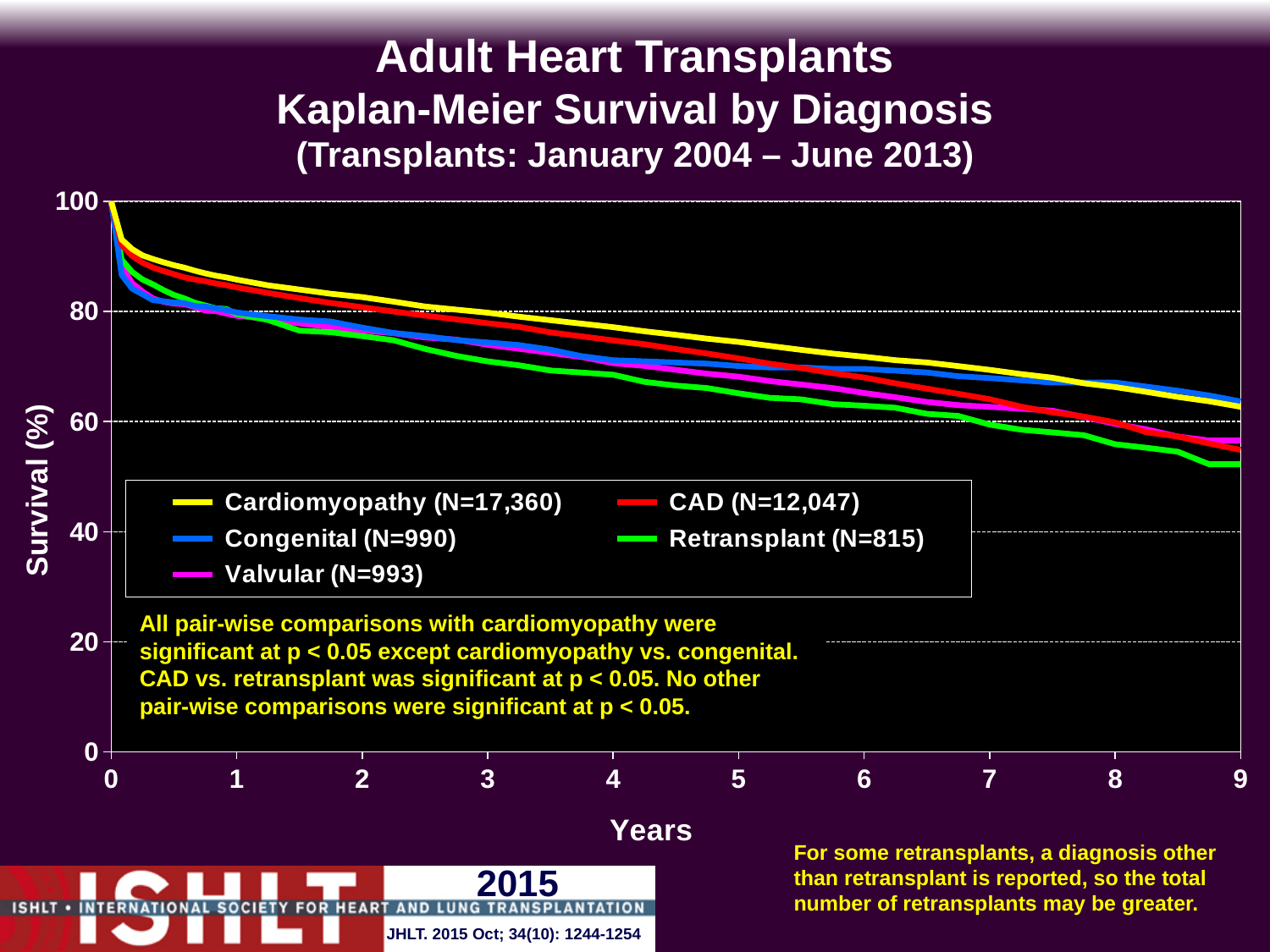
At 6 years, which has higher survival: CAD or Retransplant? CAD Is the survival for Cardiomyopathy at 9 years greater or less than 60? greater Is the survival for Valvular at 9 years greater or less than 60? less Do the survival curves rise or fall as the years increase? Fall Which colour represents the Cardiomyopathy series? Yellow Which diagnosis group has the lowest survival at 9 years? Retransplant What is the label of the y axis? Survival (%) What kind of chart is shown on the slide? Line chart Is the survival for Cardiomyopathy at 4 years greater or less than 80? less How many series does the legend list? 5 At 4 years, which has higher survival: Cardiomyopathy or Retransplant? Cardiomyopathy